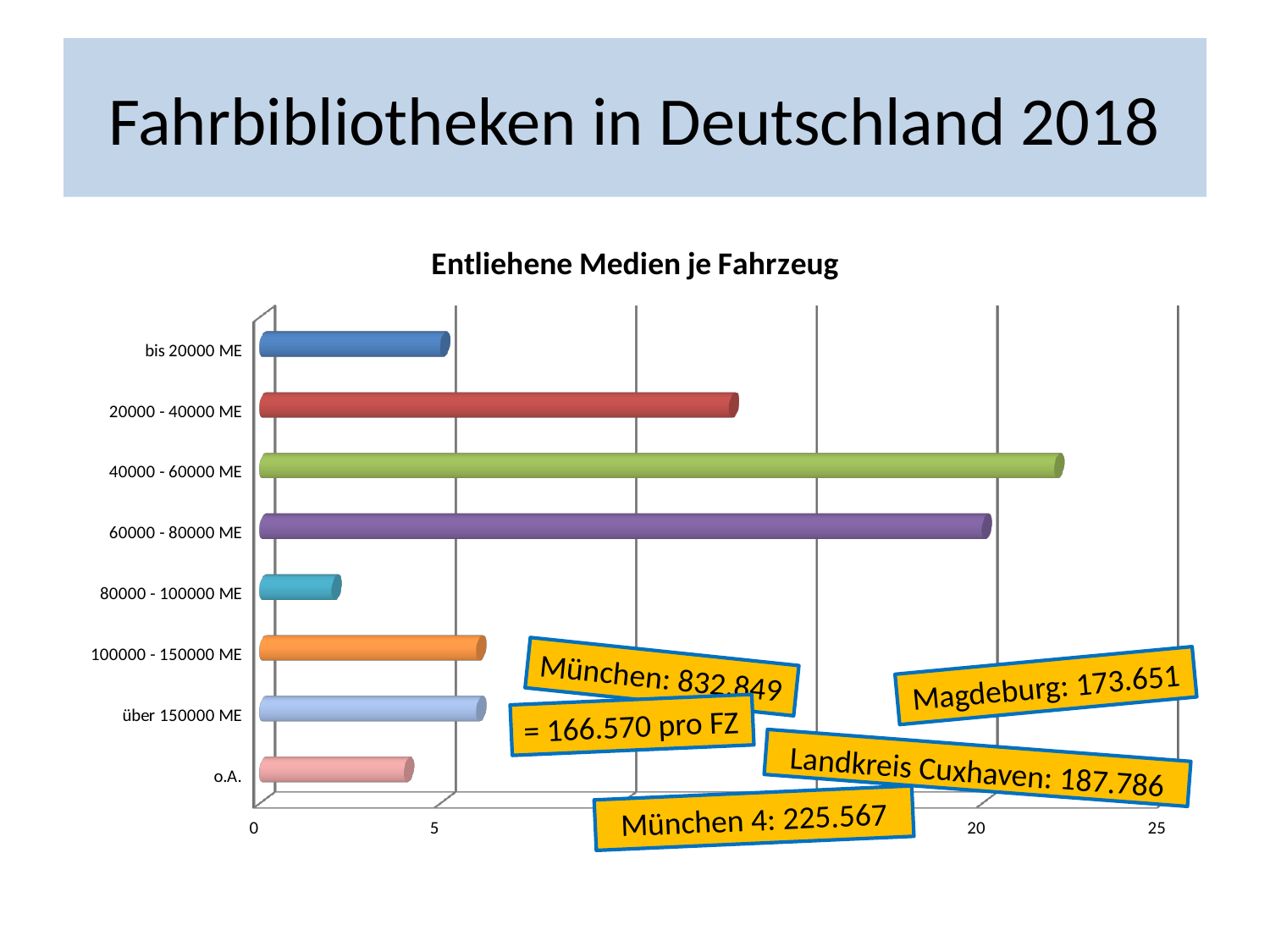
How many categories are plotted in the chart? 8 Which is larger, the value for o.A. or the value for 80000 - 100000 ME? o.A. Is the value for 20000 - 40000 ME greater or less than 10? greater Which is larger, the value for 40000 - 60000 ME or the value for 60000 - 80000 ME? 40000 - 60000 ME What kind of chart is shown under the title "Entliehene Medien je Fahrzeug"? bar chart Is the value for 40000 - 60000 ME greater or less than 20? greater Which is larger, the value for 20000 - 40000 ME or the value for bis 20000 ME? 20000 - 40000 ME Which category has the lowest value in the chart? 80000 - 100000 ME Is the value for 60000 - 80000 ME greater or less than 15? greater Which category has the highest value in the chart? 40000 - 60000 ME What is the title of the chart? Entliehene Medien je Fahrzeug